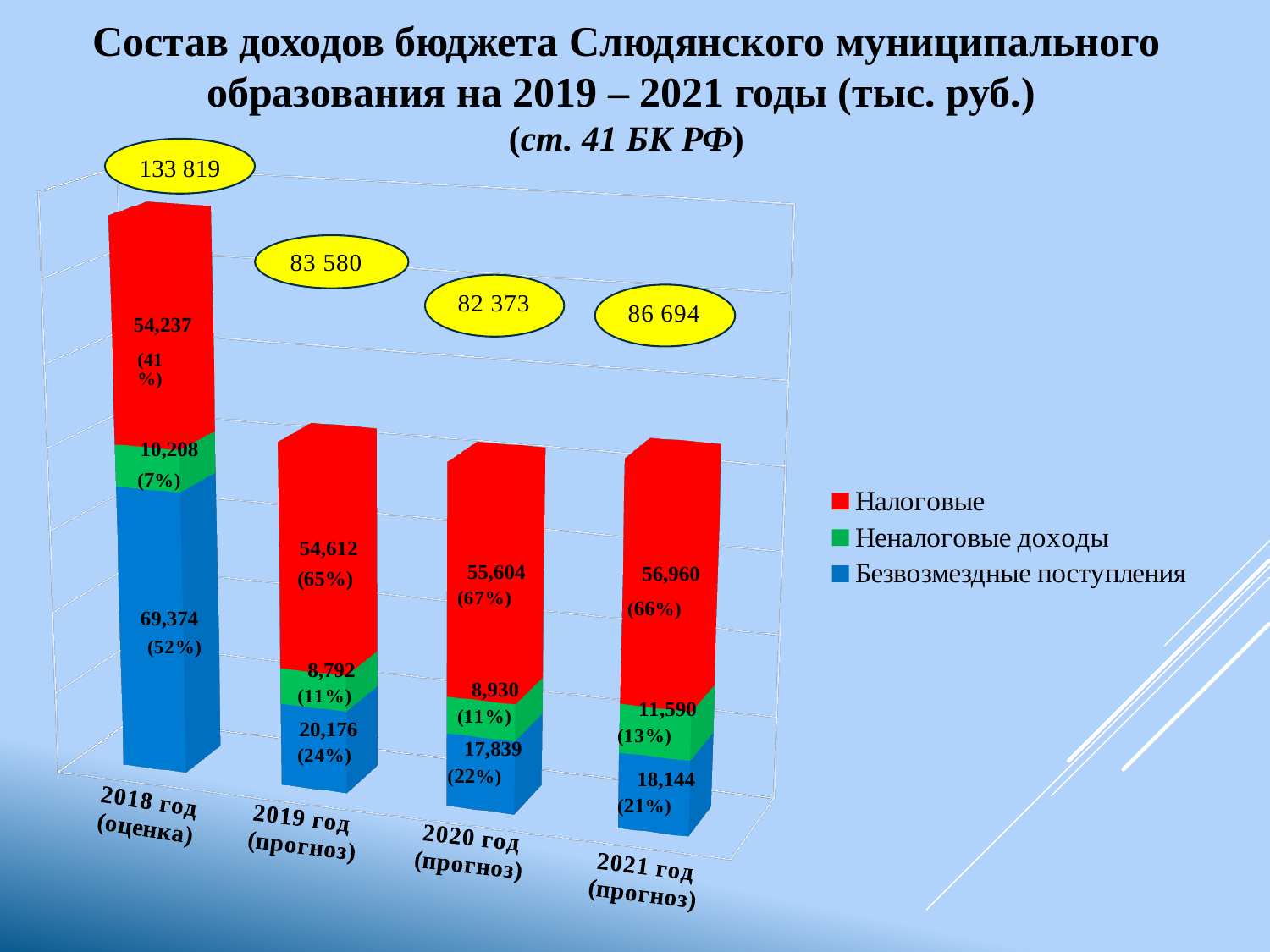
Which year has the lowest value for Безвозмездные поступления? 2020 год (прогноз) What is the value of Безвозмездные поступления for 2018 год (оценка)? 69,374 What type of chart is shown on the slide? Stacked bar chart How many categories (years) are shown on the x axis? 4 What is the difference between Налоговые in 2021 год (прогноз) and 2020 год (прогноз)? 1,356 What percentage share is shown for Налоговые in 2020 год (прогноз)? 67% Which year has the highest total budget income? 2018 год (оценка) How many series does the legend list? 3 What is the total shown for 2021 год (прогноз)? 86 694 What is the value of Неналоговые доходы for 2021 год (прогноз)? 11,590 Which series is shown in red in the legend? Налоговые What is the value of Налоговые for 2019 год (прогноз)? 54,612